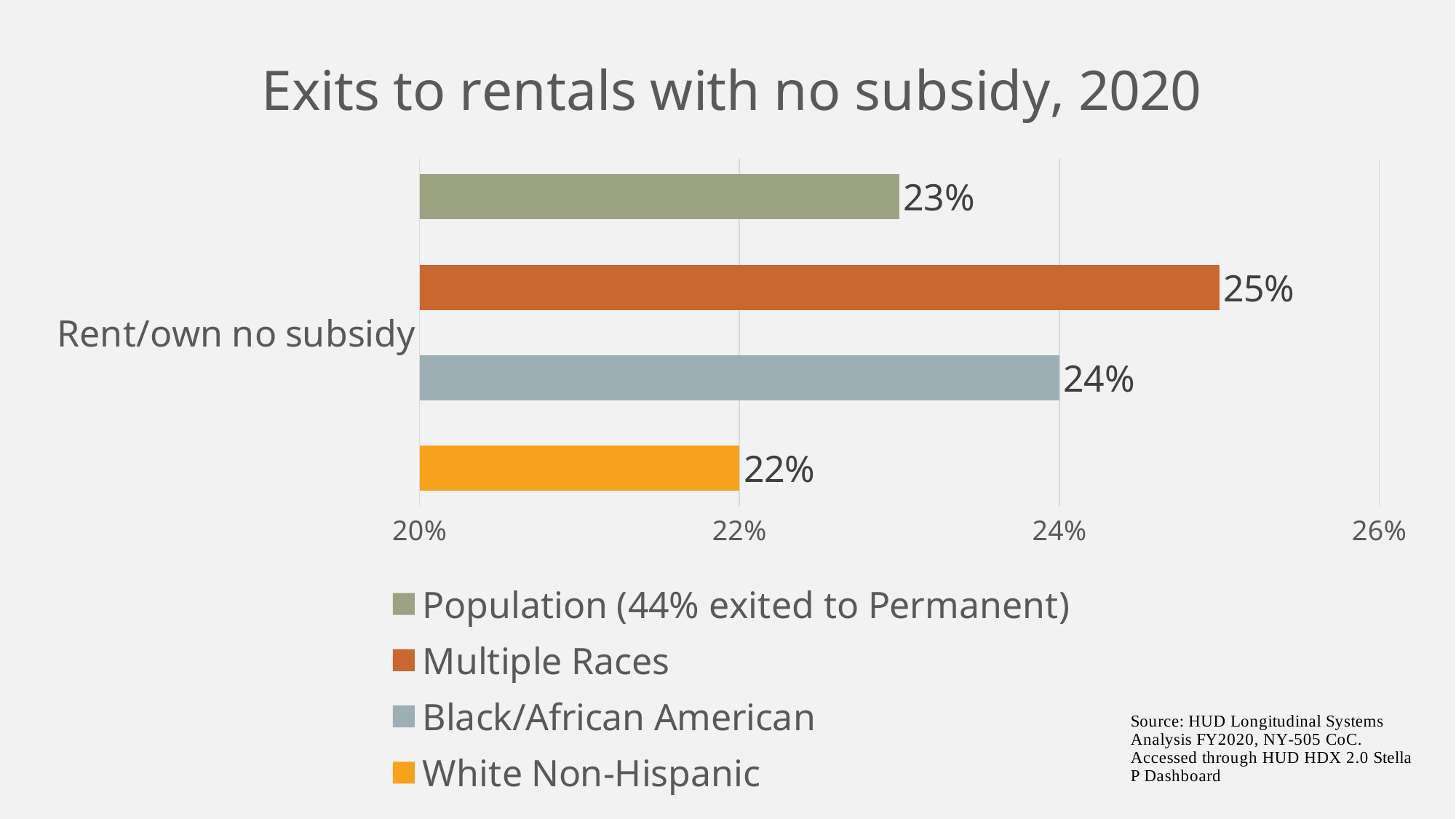
Which is larger, the value for Black/African American or the value for Population (44% exited to Permanent)? Black/African American What is the value for Black/African American? 24% What kind of chart is shown on the slide? Bar chart How many series does the legend list? 4 What is the value for Multiple Races? 25% What is the difference between the values for Multiple Races and White Non-Hispanic? 3% What is the title of the chart? Exits to rentals with no subsidy, 2020 Which series has the lowest value? White Non-Hispanic Which series has the highest value? Multiple Races What is the value for White Non-Hispanic? 22% What is the value for the Population (44% exited to Permanent) series? 23% What colour is the bar for White Non-Hispanic? Orange